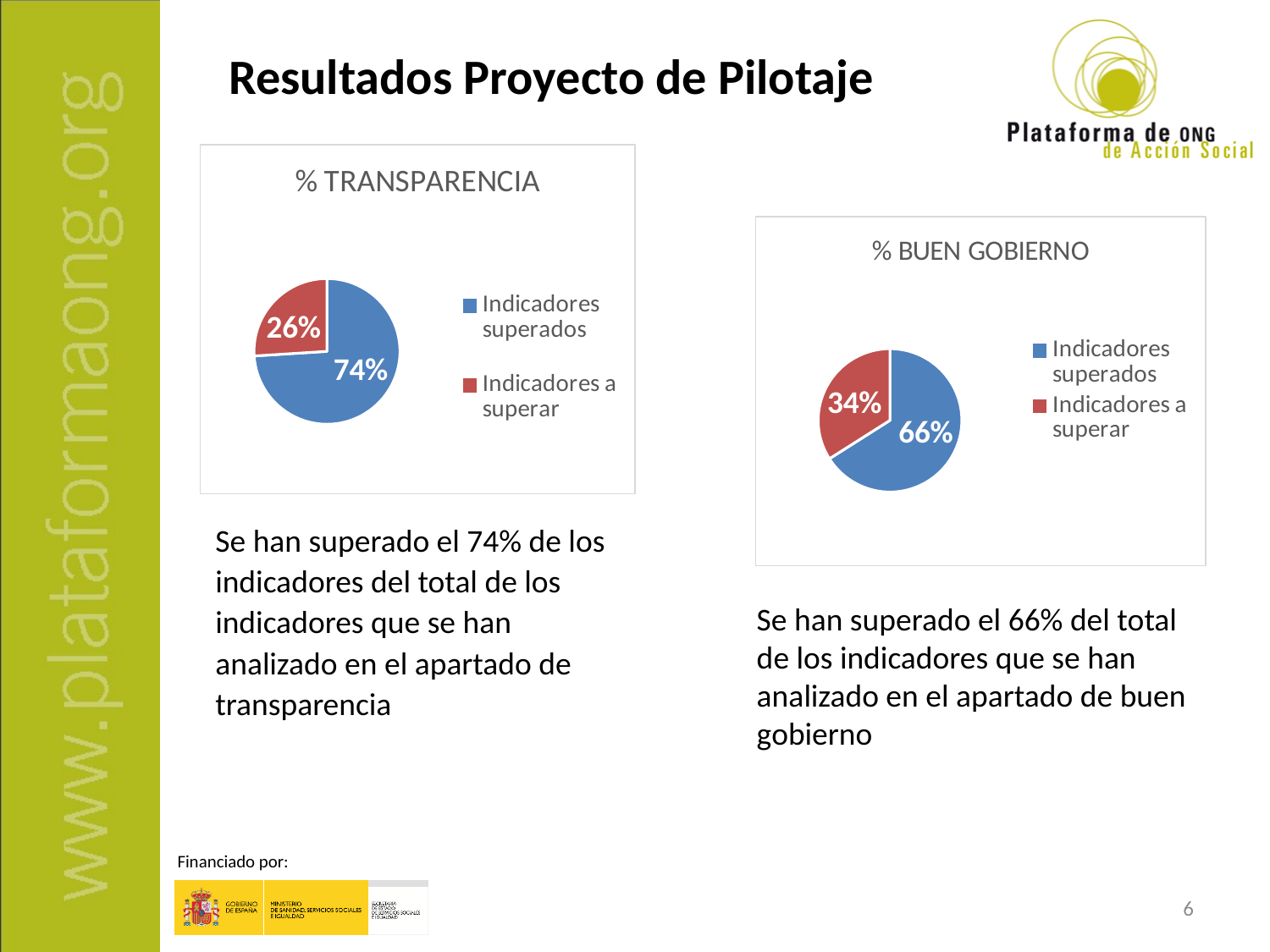
In the "% TRANSPARENCIA" chart, what is the difference between "Indicadores superados" and "Indicadores a superar"? 48% In the "% BUEN GOBIERNO" chart, what colour is the "Indicadores a superar" slice? Red How many slices does the "% TRANSPARENCIA" pie chart have? 2 In the "% TRANSPARENCIA" chart, which category has the largest slice? Indicadores superados In the "% BUEN GOBIERNO" chart, what is the value for "Indicadores superados"? 66% What kind of chart is the "% BUEN GOBIERNO" chart? Pie chart In the "% TRANSPARENCIA" chart, what is the value for "Indicadores a superar"? 26% In the "% BUEN GOBIERNO" chart, what is the difference between "Indicadores superados" and "Indicadores a superar"? 32% In the "% TRANSPARENCIA" chart, what is the value for "Indicadores superados"? 74% Which is larger: "Indicadores superados" in the "% TRANSPARENCIA" chart or "Indicadores superados" in the "% BUEN GOBIERNO" chart? % TRANSPARENCIA In the "% BUEN GOBIERNO" chart, what is the value for "Indicadores a superar"? 34% In the "% BUEN GOBIERNO" chart, which category has the smallest slice? Indicadores a superar